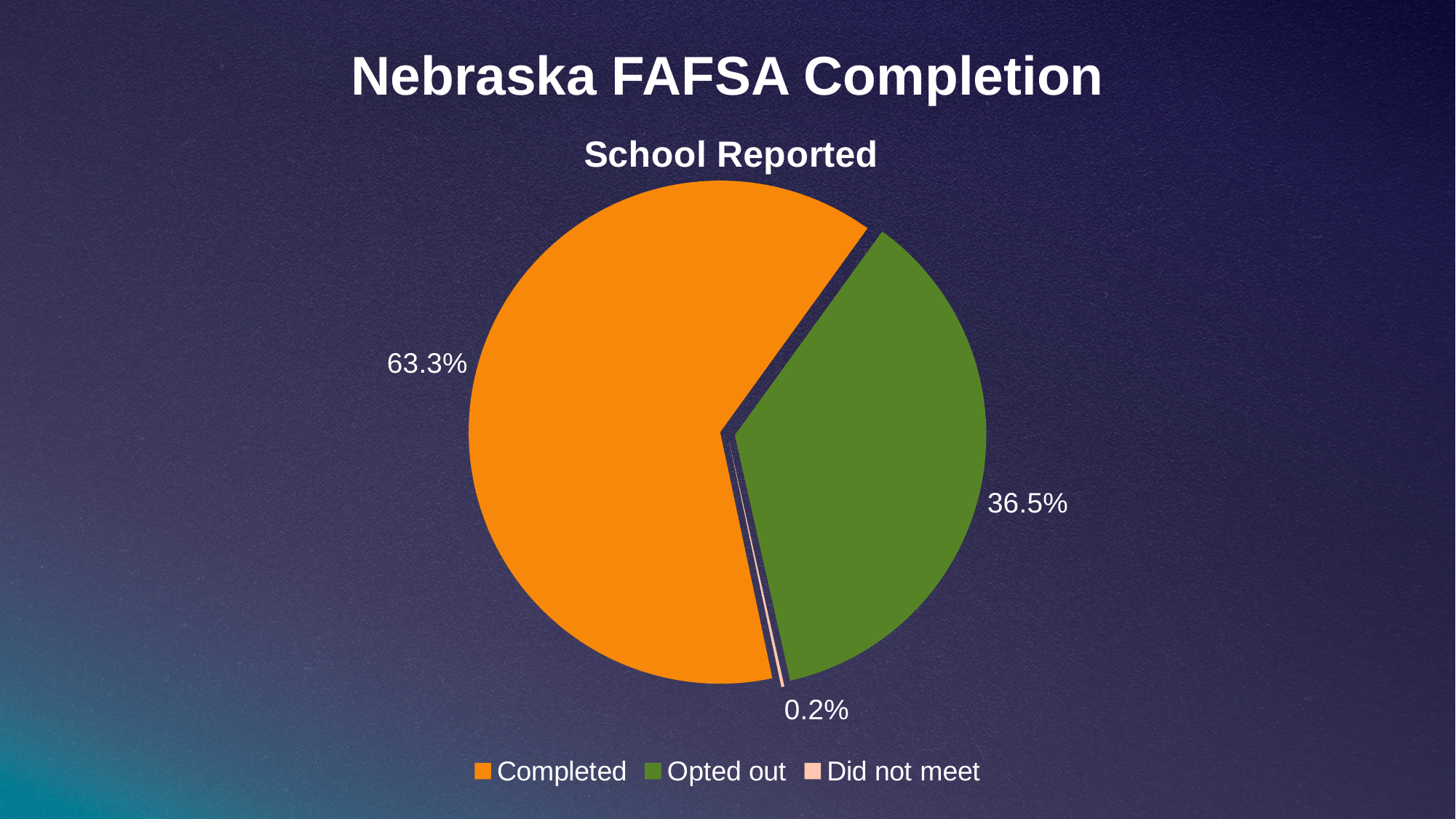
What colour is the Opted out slice? Green Which is larger, the Opted out slice or the Did not meet slice? Opted out What share of the pie is labelled Completed? 63.3% Which category has the largest slice of the pie? Completed What share of the pie is labelled Did not meet? 0.2% Which category has the smallest slice of the pie? Did not meet What is the chart's title? School Reported How many entries does the legend list? 3 How many categories does the pie chart show? 3 What type of chart is shown on the slide? Pie chart What is the difference in percentage points between the Completed and Opted out slices? 26.8 What share of the pie is labelled Opted out? 36.5%